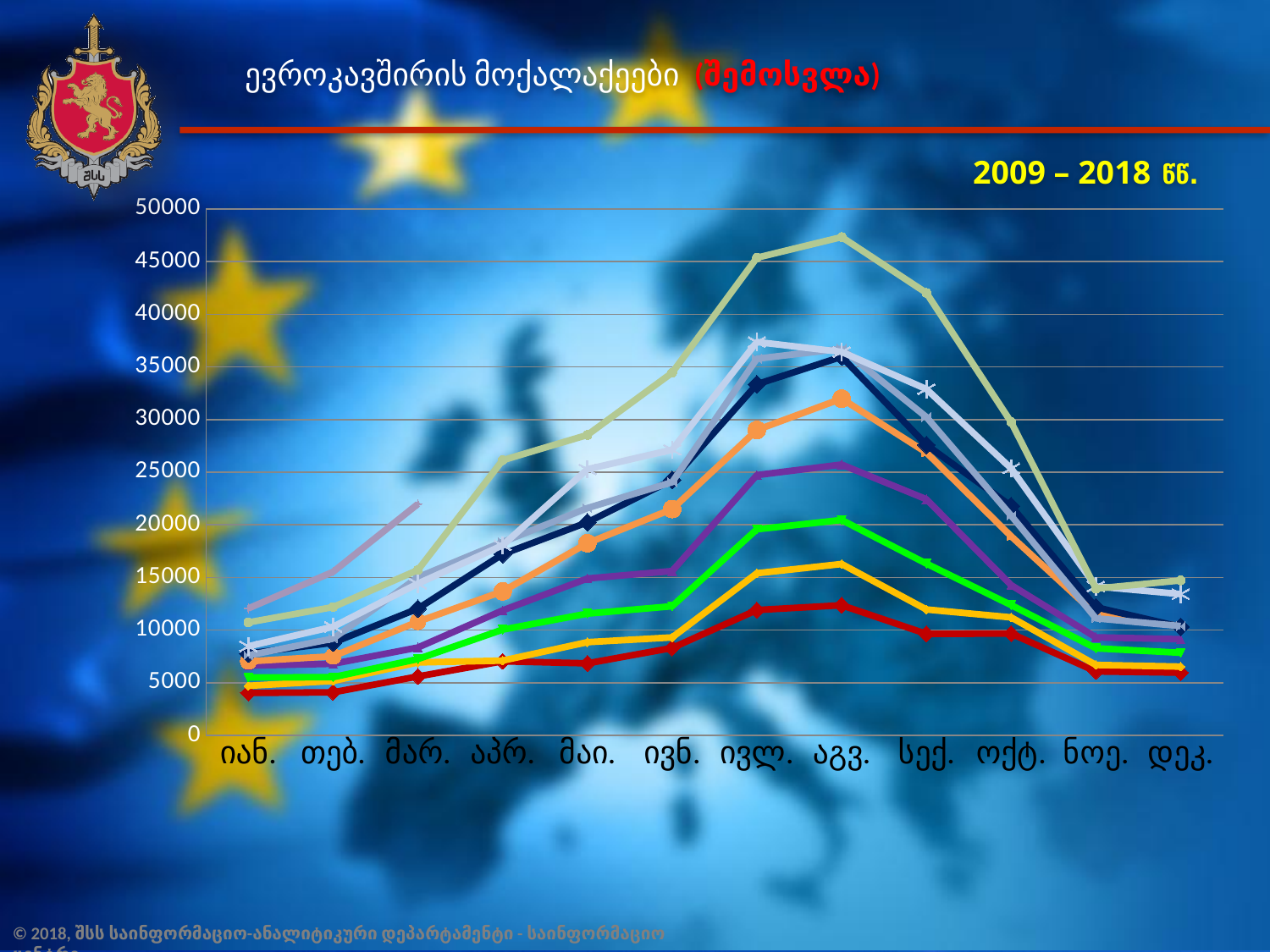
What kind of chart is shown on the slide? line chart How many months are shown along the x axis of the chart? 12 What is the highest value shown on the y axis of the chart? 50000 Is the value of the topmost line in ოქტ. greater or less than 25000? greater Do the lines generally rise or fall from აგვ. to ნოე.? fall What period of years does the chart cover, as stated on the slide? 2009 – 2018 წწ. Is the value of the lowest (red) line in იან. greater or less than 5000? less In which month does the topmost line reach its highest point? აგვ. Is the value of the lowest (red) line in აგვ. greater or less than 15000? less Do the lines generally rise or fall from იან. to აგვ.? rise